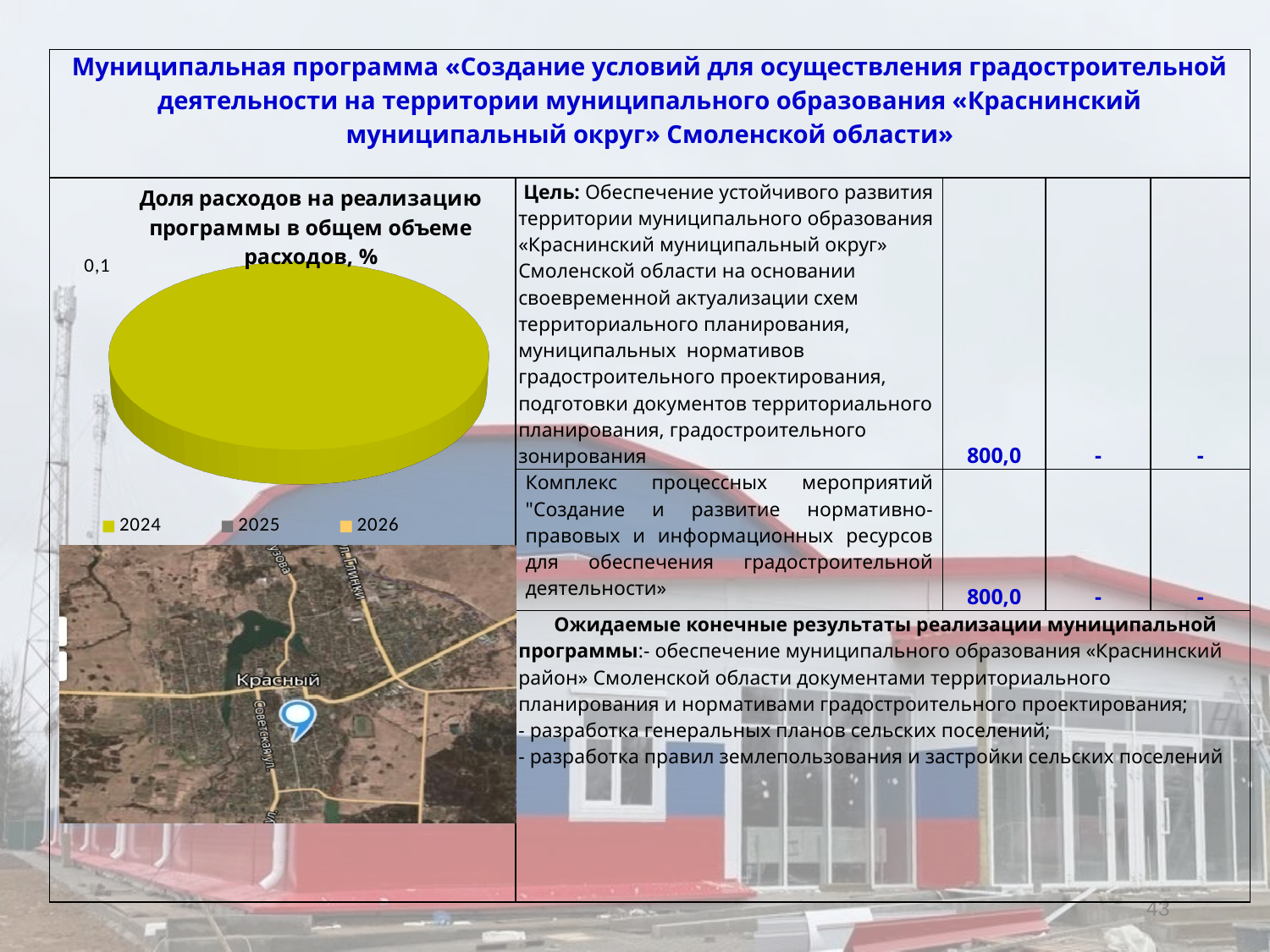
What is the title of the chart on the slide? Доля расходов на реализацию программы в общем объеме расходов, % What kind of chart is shown on the slide? pie chart Which years are listed in the chart's legend? 2024, 2025, 2026 Which year's slice is the largest in the pie chart? 2024 How many entries does the chart's legend list? 3 What colour is the 2024 slice in the pie chart? yellow What value is printed as the data label on the pie chart? 0,1